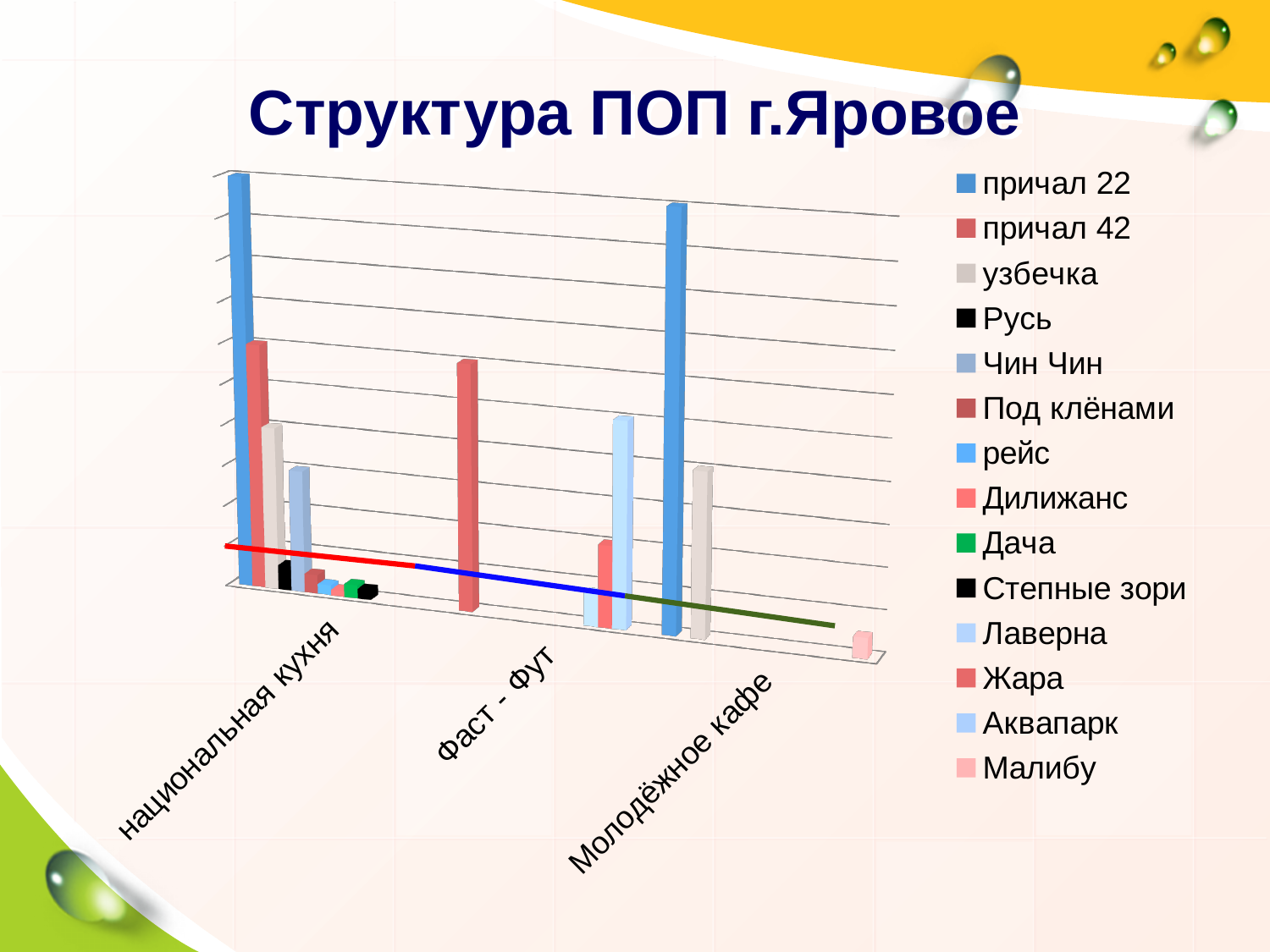
Which series is listed first in the legend? причал 22 How many categories are shown on the x axis? 3 What kind of chart is shown on the slide? bar chart Which series has the tallest bar in the 'национальная кухня' category? причал 22 In the 'национальная кухня' category, which bar is taller: причал 42 or узбечка? причал 42 Which series has the tallest bar in the 'Молодёжное кафе' category? причал 22 Does the line drawn across the chart rise or fall from left to right? fall What is the title of the chart? Структура ПОП г.Яровое Which category has the fewest visible bars? Молодёжное кафе How many series does the legend list? 14